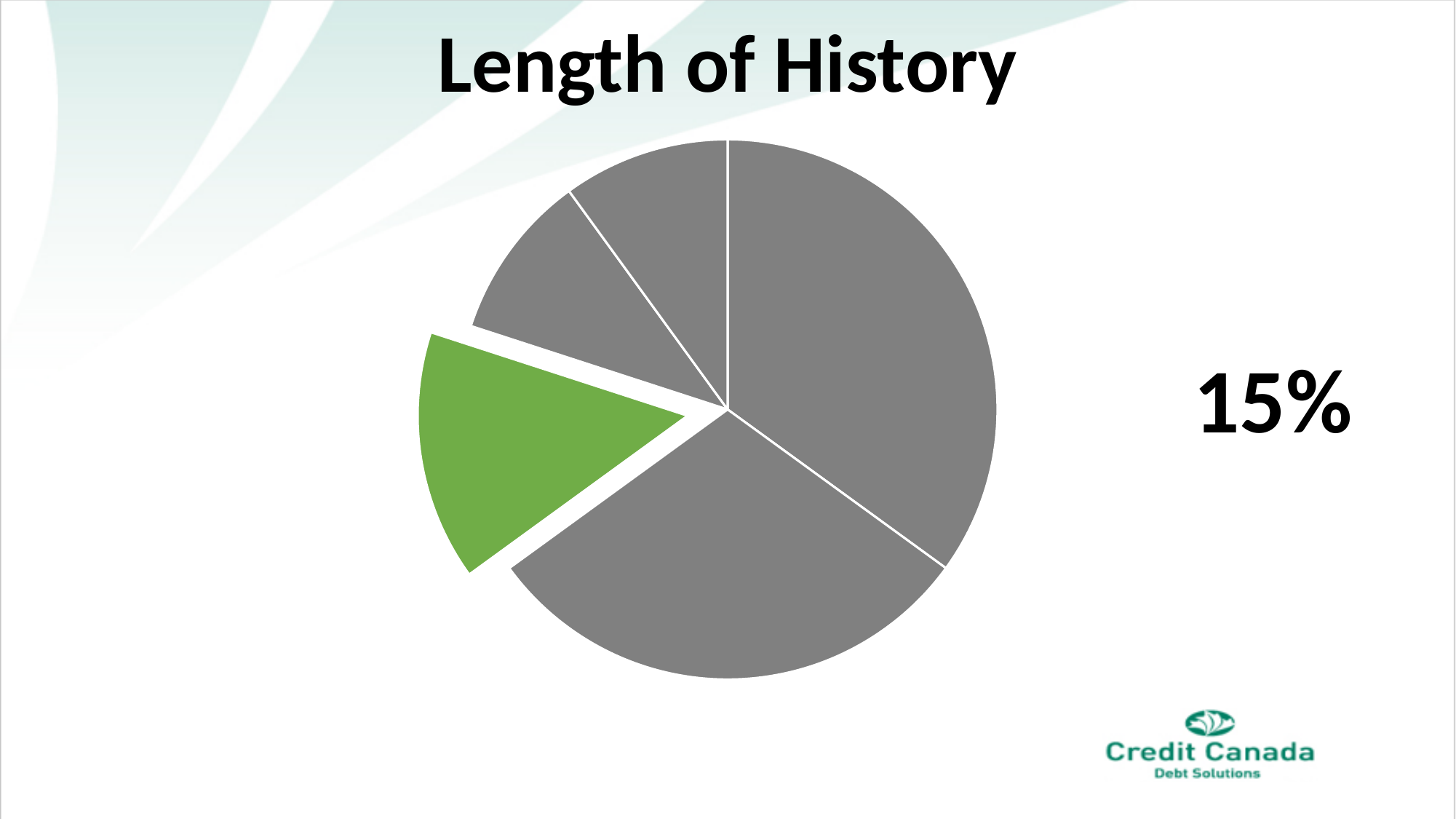
What kind of chart is shown on the slide? pie chart Is the green slice the largest slice of the pie? No What colour is the slice that is pulled out from the pie? green What share of the pie does the highlighted green slice represent? 15% How many slices does the pie chart have? 5 What percentage is printed beside the pie chart? 15% What is the title of the chart? Length of History Is the share of the green slice greater or less than 50%? less